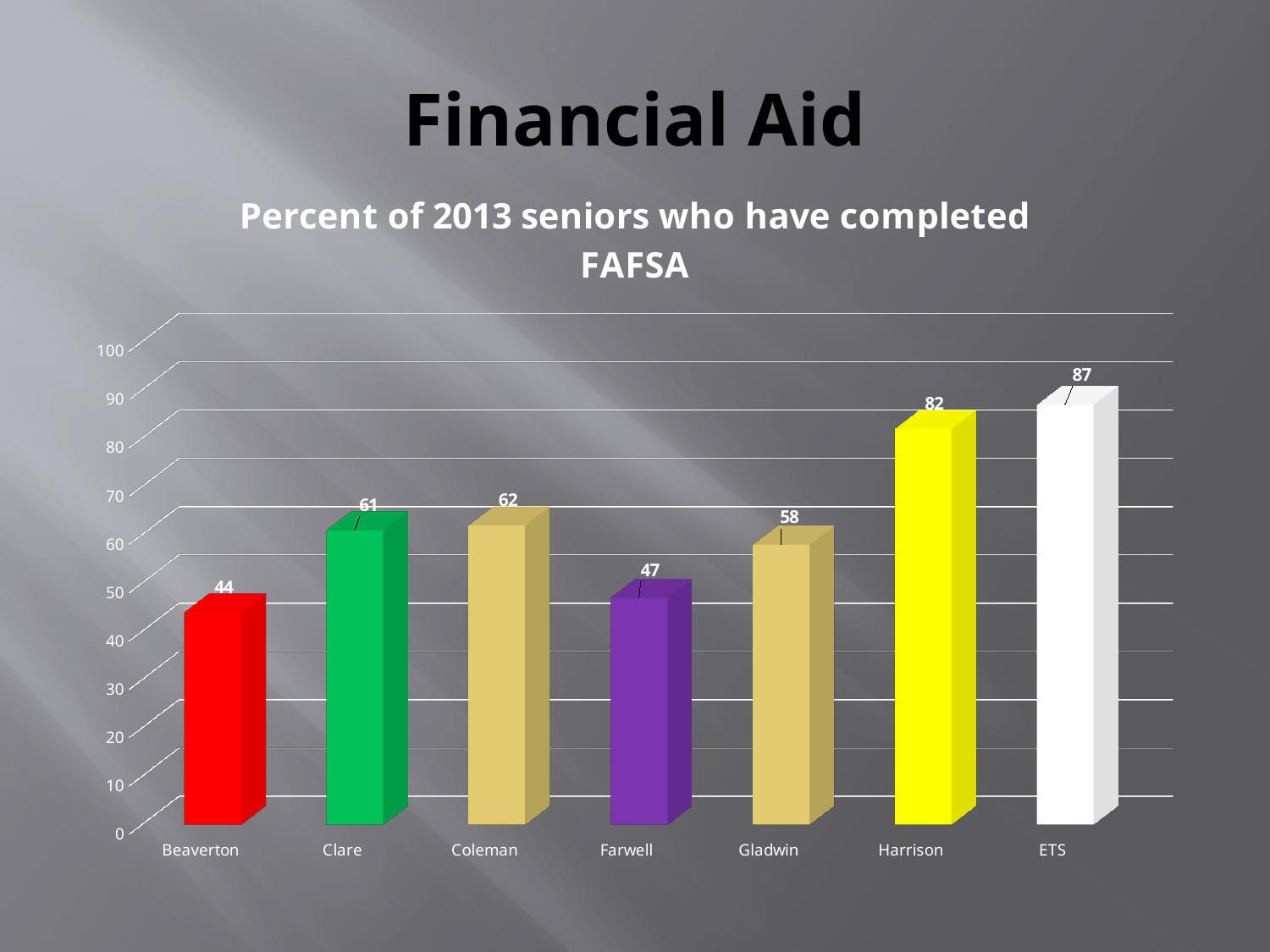
What is the title of the chart? Percent of 2013 seniors who have completed FAFSA What is the value for Farwell? 47 Which is larger, the value for Clare or the value for Farwell? Clare What is the difference between the values for Coleman and Gladwin? 4 Which category has the highest value? ETS How many categories are shown on the x axis? 7 What is the value for Harrison? 82 What kind of chart is shown on the slide? bar chart Which category has the lowest value? Beaverton What is the value for Beaverton? 44 Is the value for Gladwin greater or less than 50? greater What is the difference between the values for ETS and Beaverton? 43